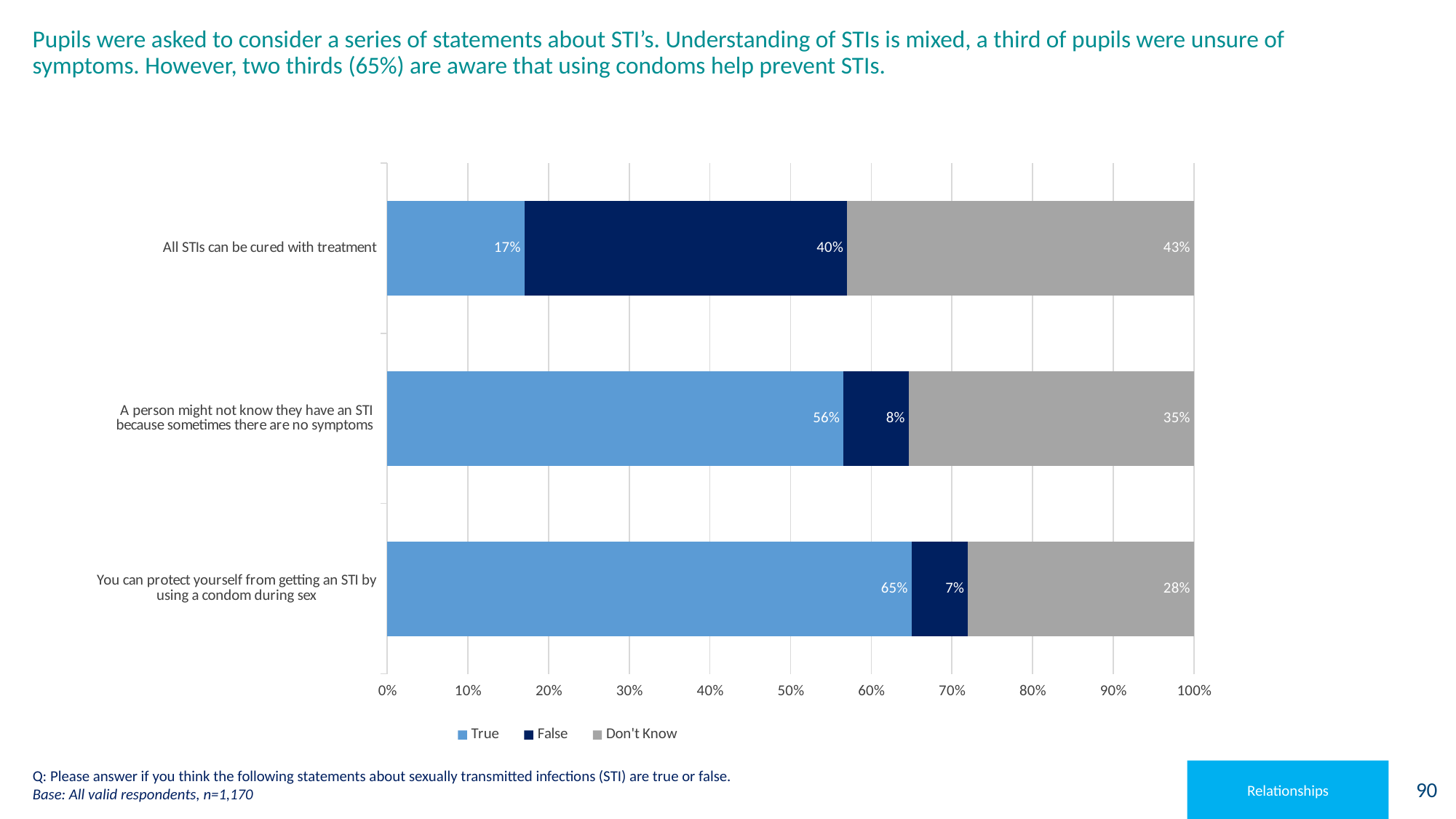
How many statements are shown in the chart? 3 What percentage of pupils said 'False' to the statement 'You can protect yourself from getting an STI by using a condom during sex'? 7% Which legend entry is shown in grey? Don't Know Which statement has the highest 'True' percentage? You can protect yourself from getting an STI by using a condom during sex What percentage of pupils answered 'Don't Know' for the statement 'A person might not know they have an STI because sometimes there are no symptoms'? 35% Which is larger for the statement 'All STIs can be cured with treatment': the 'False' share or the 'Don't Know' share? Don't Know What is the total of the 'True' and 'False' segments for the statement 'A person might not know they have an STI because sometimes there are no symptoms'? 64% Which statement has the lowest 'Don't Know' percentage? You can protect yourself from getting an STI by using a condom during sex How many series does the legend list? 3 What percentage of pupils said 'True' to the statement 'All STIs can be cured with treatment'? 17% What is the difference between the 'False' percentage for 'All STIs can be cured with treatment' and the 'False' percentage for 'A person might not know they have an STI because sometimes there are no symptoms'? 32 percentage points What type of chart is shown on the slide? Stacked bar chart